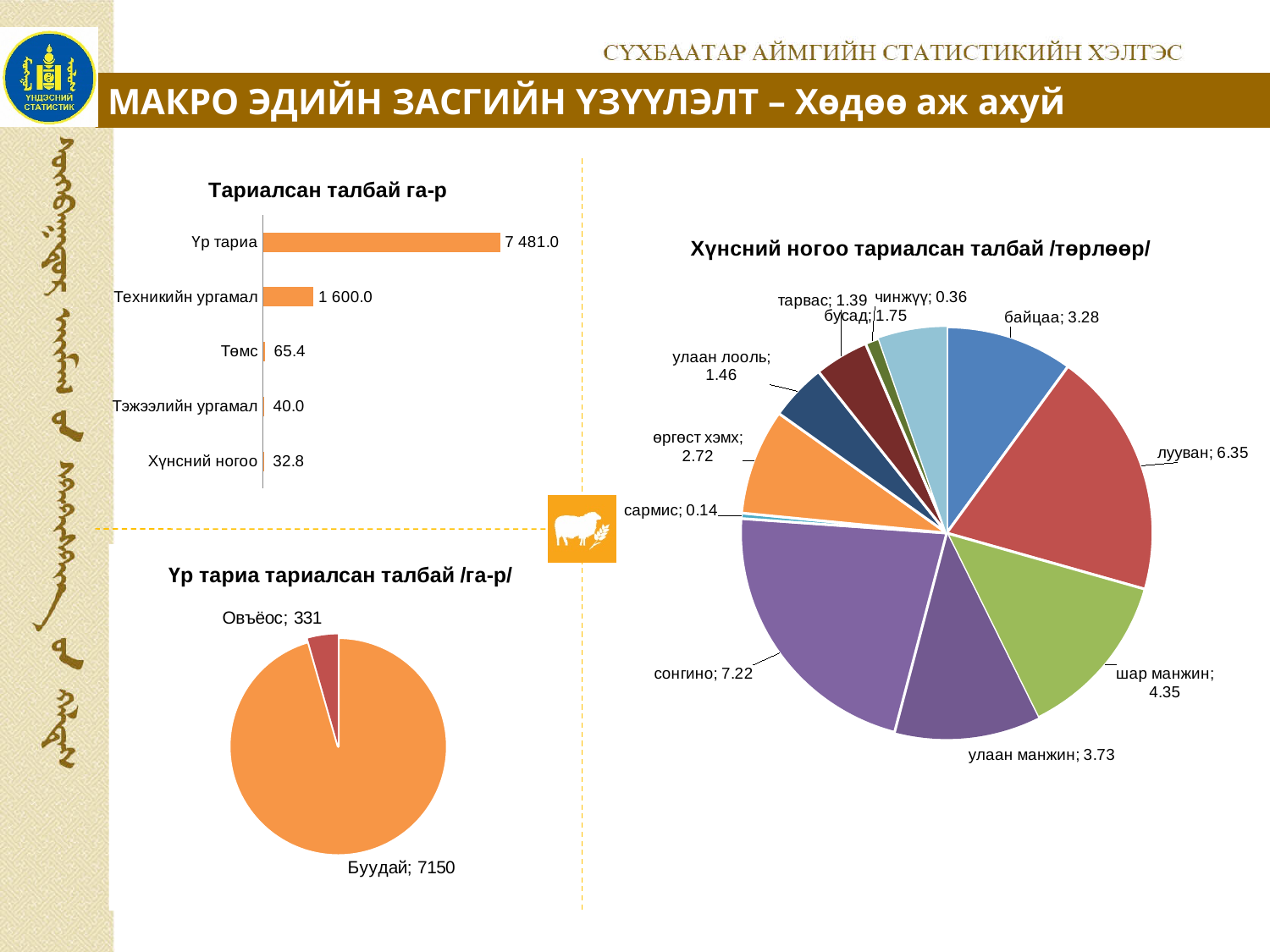
In the chart titled "Хүнсний ногоо тариалсан талбай /төрлөөр/", which is larger, лууван or байцаа? лууван What kind of chart is the one titled "Тариалсан талбай га-р"? bar chart In the chart titled "Тариалсан талбай га-р", what is the value for Төмс? 65.4 In the chart titled "Тариалсан талбай га-р", which category has the lowest value? Хүнсний ногоо In the chart titled "Тариалсан талбай га-р", how many categories are shown? 5 In the chart titled "Хүнсний ногоо тариалсан талбай /төрлөөр/", what is the value for шар манжин? 4.35 In the chart titled "Хүнсний ногоо тариалсан талбай /төрлөөр/", how many slices are there? 11 In the chart titled "Тариалсан талбай га-р", what is the value for Үр тариа? 7 481.0 In the chart titled "Үр тариа тариалсан талбай /га-р/", what is the total of the two slices? 7481 In the chart titled "Үр тариа тариалсан талбай /га-р/", what is the value for Буудай? 7150 In the chart titled "Хүнсний ногоо тариалсан талбай /төрлөөр/", which category has the largest slice? сонгино In the chart titled "Тариалсан талбай га-р", what is the difference between Үр тариа and Техникийн ургамал? 5 881.0